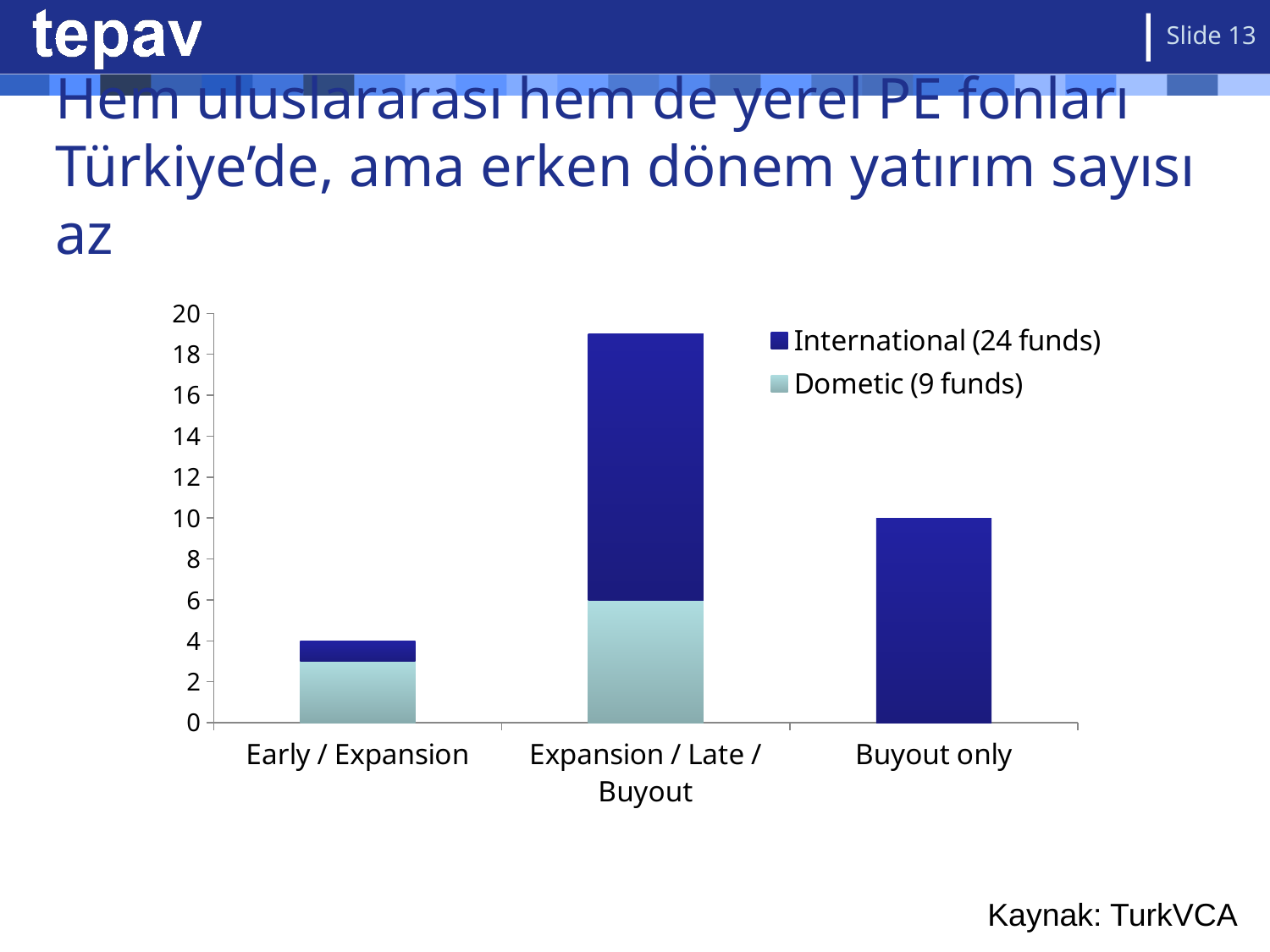
Is the total value for Expansion / Late / Buyout greater or less than 16? greater Which category has the shortest stacked bar? Early / Expansion Which category has no Dometic (9 funds) segment in its bar? Buyout only What value does the Buyout only bar reach on the y axis? 10 What are the two entries listed in the chart's legend? International (24 funds) and Dometic (9 funds) What kind of chart is shown on the slide? bar chart Is the value for Buyout only greater or less than 14? less Which category has the tallest stacked bar? Expansion / Late / Buyout How many categories are shown on the x axis of the chart? 3 Is the total value for Early / Expansion greater or less than 6? less How many series does the chart's legend list? 2 Which is larger, the bar for Buyout only or the bar for Early / Expansion? Buyout only